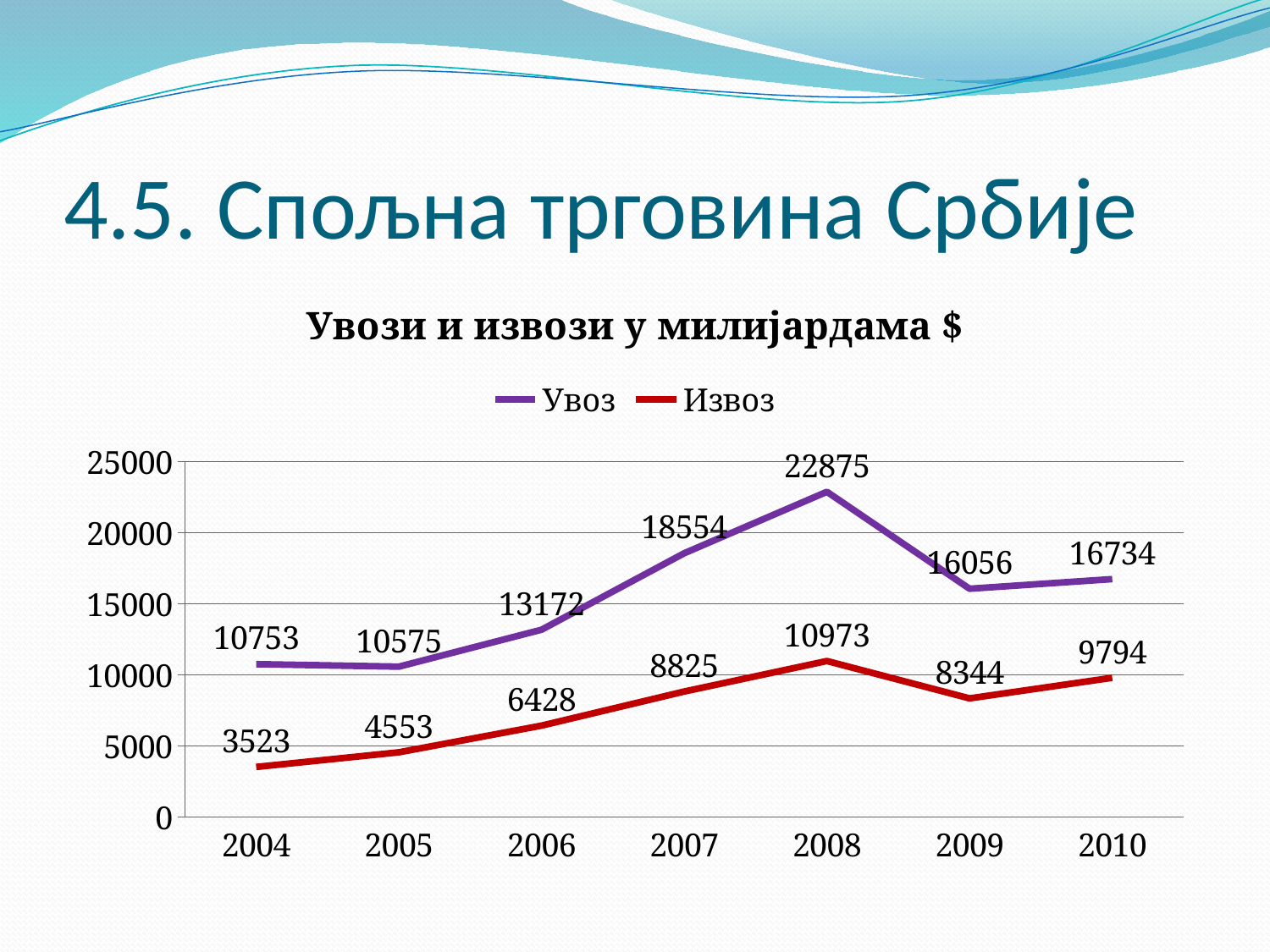
How many years are shown on the x axis? 7 What kind of chart is shown on the slide? Line chart In which year is Извоз lowest? 2004 What is the value of Увоз in 2008? 22875 In which year is Увоз highest? 2008 What is the value of Извоз in 2004? 3523 What is the title of the chart? Увози и извози у милијардама $ What is the difference between Увоз and Извоз in 2008? 11902 How many series does the legend list? 2 Does Извоз rise or fall from 2004 to 2008? Rise Which is larger: Увоз in 2009 or Увоз in 2010? Увоз in 2010 What is the value of Извоз in 2010? 9794